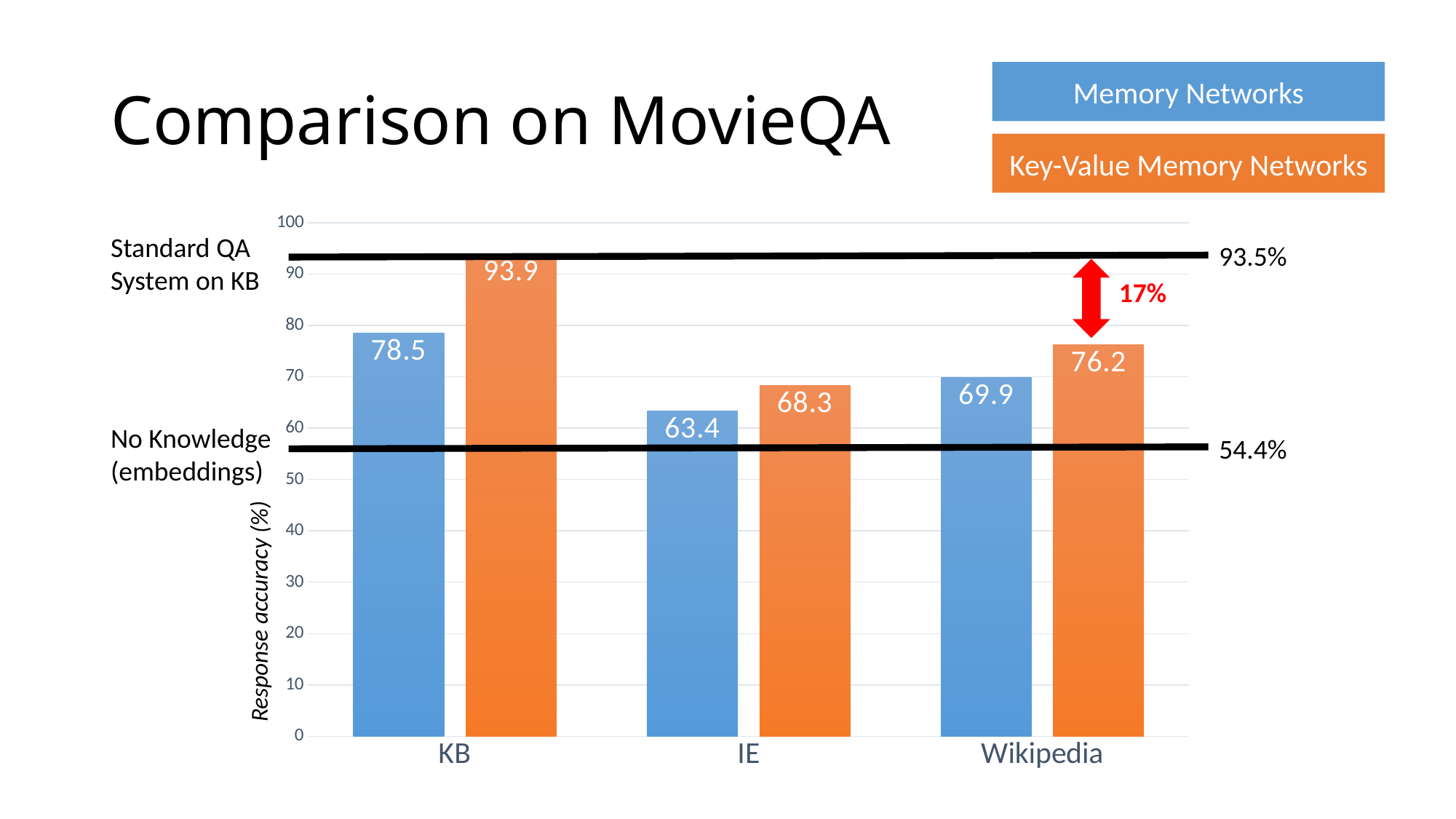
What is the response accuracy of Memory Networks on IE? 63.4 What is the response accuracy of Key-Value Memory Networks on Wikipedia? 76.2 What is the response accuracy of Memory Networks on KB? 78.5 Which knowledge source gives the highest accuracy for Key-Value Memory Networks? KB How many knowledge sources are shown on the x axis? 3 What accuracy is marked by the horizontal line labelled 'Standard QA System on KB'? 93.5% What is the response accuracy of Key-Value Memory Networks on KB? 93.9 What kind of chart is shown on the slide? Bar chart What is the difference between Key-Value Memory Networks and Memory Networks on KB? 15.4 How many series does the legend list? 2 Which knowledge source gives the lowest accuracy for Memory Networks? IE Which is larger on Wikipedia: Memory Networks or Key-Value Memory Networks? Key-Value Memory Networks